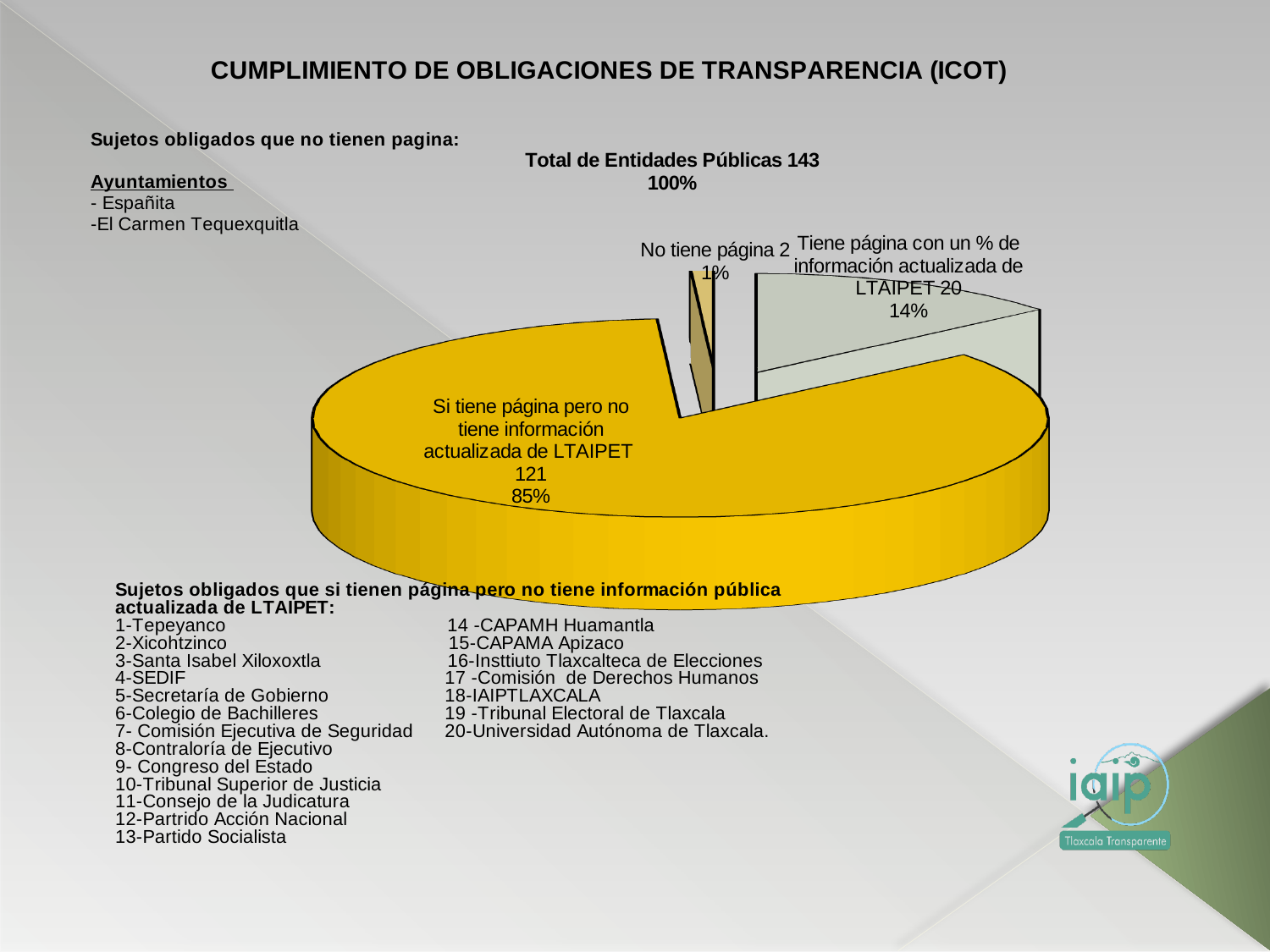
What percentage share does the slice 'Si tiene página pero no tiene información actualizada de LTAIPET' have? 85% Which slice of the pie chart is the largest? Si tiene página pero no tiene información actualizada de LTAIPET How many slices does the pie chart have? 3 What is the value for the slice 'Si tiene página pero no tiene información actualizada de LTAIPET'? 121 What percentage share does the slice 'Tiene página con un % de información actualizada de LTAIPET' have? 14% What kind of chart is shown on the slide? pie chart What is the value for the slice 'No tiene página'? 2 What is the difference between the value for 'Si tiene página pero no tiene información actualizada de LTAIPET' and the value for 'Tiene página con un % de información actualizada de LTAIPET'? 101 What percentage share does the slice 'No tiene página' have? 1% What is the value for the slice 'Tiene página con un % de información actualizada de LTAIPET'? 20 Which slice of the pie chart is the smallest? No tiene página What is the total number of public entities stated above the pie chart? 143